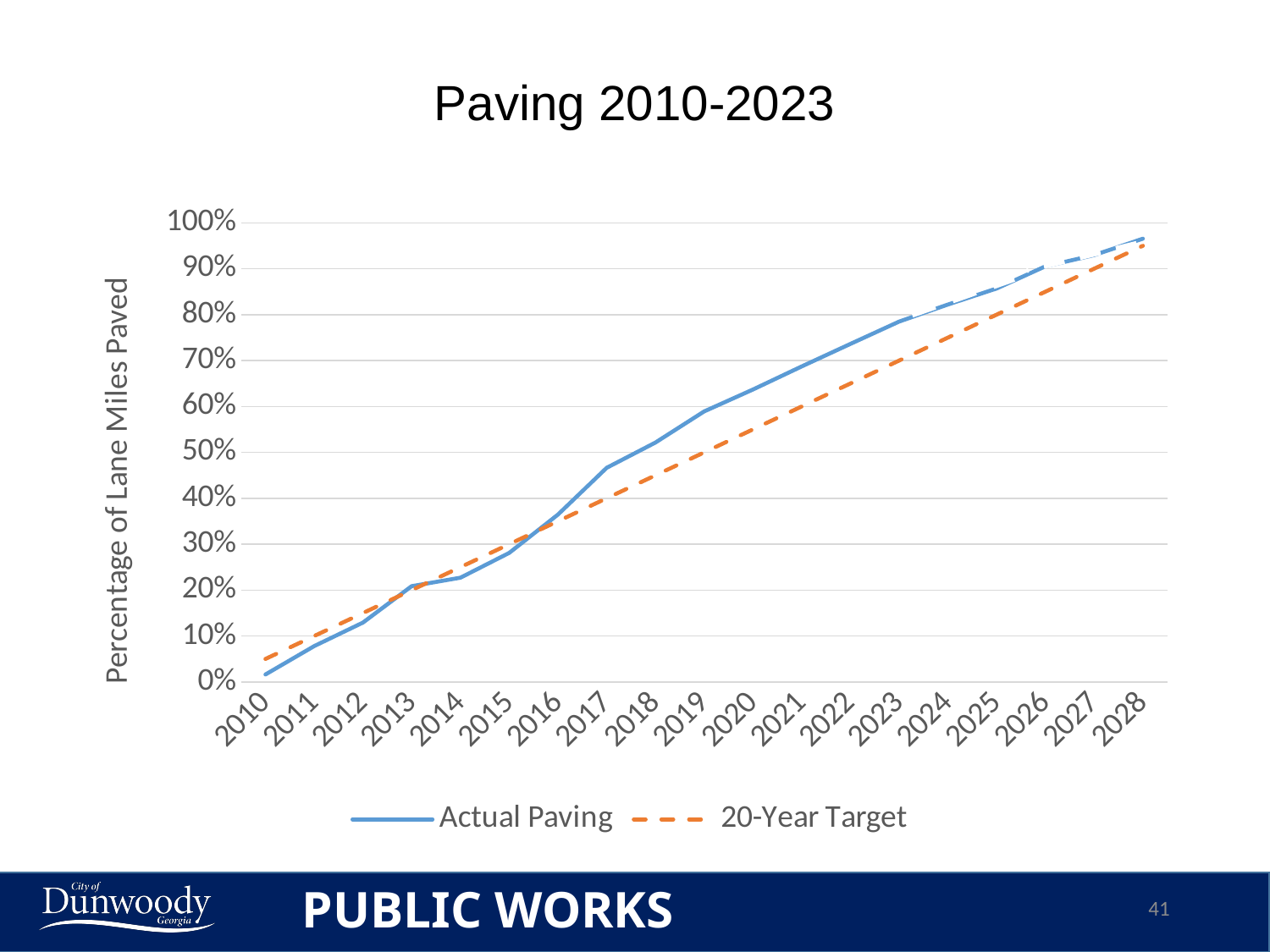
In 2019, which is higher: Actual Paving or 20-Year Target? Actual Paving How many series does the legend list? 2 Is the 20-Year Target value for 2028 greater or less than 90%? greater What kind of chart is shown on the slide? line chart In 2011, which is higher: Actual Paving or 20-Year Target? 20-Year Target Is the Actual Paving value for 2019 greater or less than 50%? greater Does the Actual Paving line rise or fall from 2010 to 2028? rise How many years are shown along the x axis? 19 What is the label on the y axis? Percentage of Lane Miles Paved Is the Actual Paving value for 2017 greater or less than 50%? less